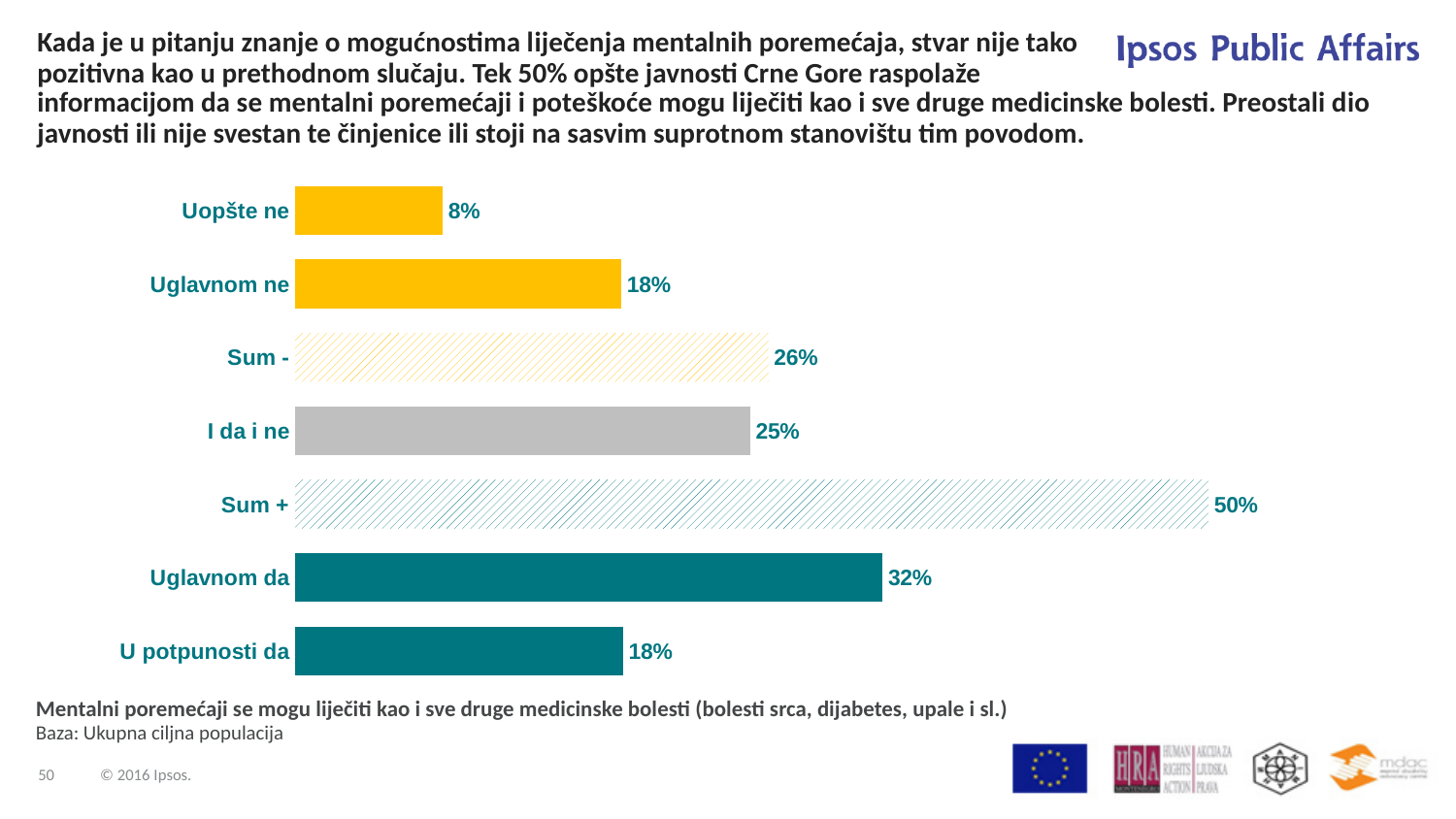
How many categories are shown in the chart? 7 What kind of chart is shown on the slide? Bar chart What is the value for "I da i ne"? 25% Which is larger, "Uglavnom da" or "U potpunosti da"? Uglavnom da What is the difference between "Uglavnom da" and "Uglavnom ne"? 14% What is the difference between "Sum +" and "Sum -"? 24% What is the value for "Uopšte ne"? 8% Which category has the lowest value? Uopšte ne What is the value for "Sum +"? 50% What is the value for "Sum -"? 26% Which category has the highest value? Sum + What is the value for "Uglavnom da"? 32%